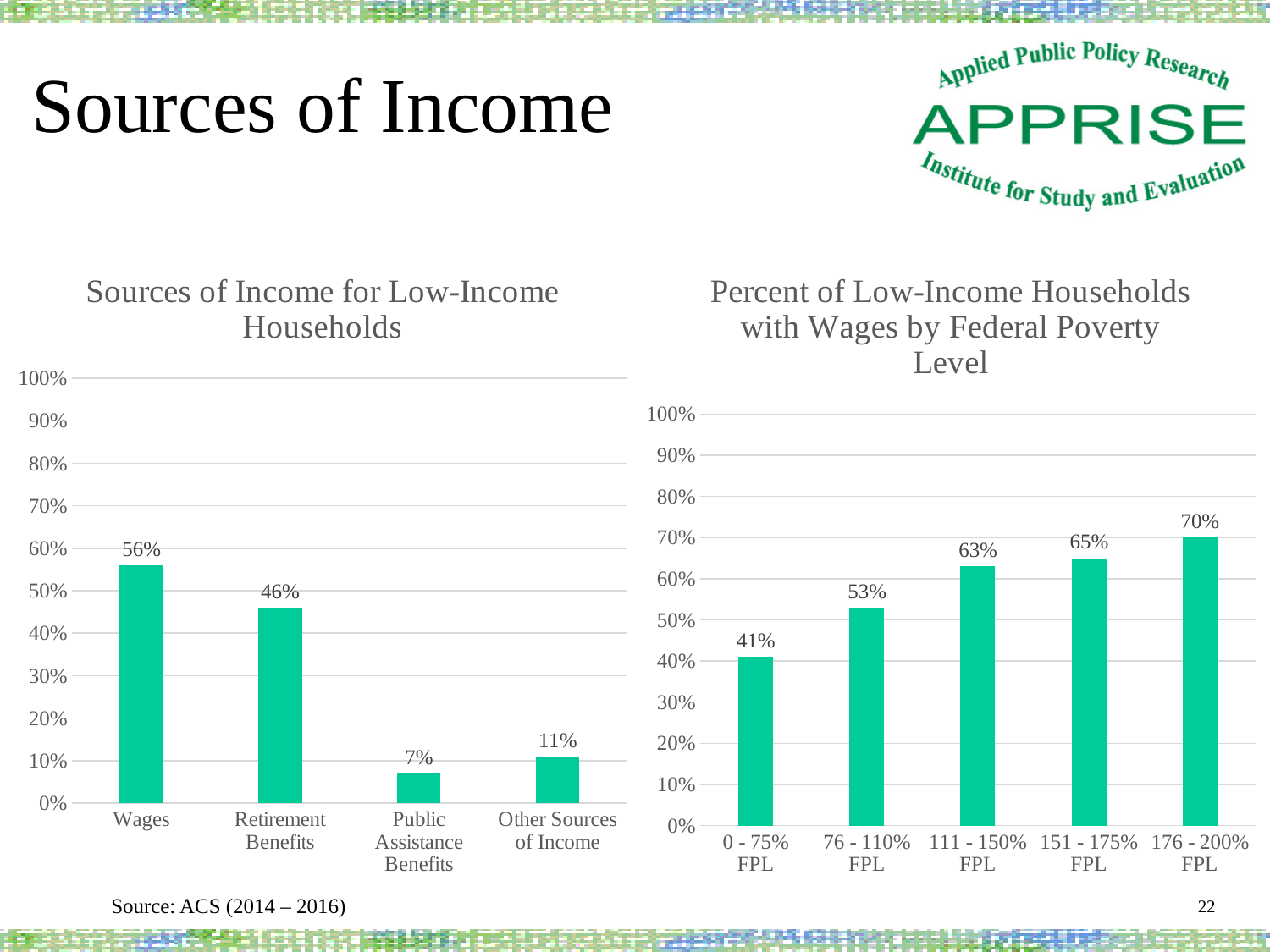
In the 'Sources of Income for Low-Income Households' chart, what is the difference between Wages and Retirement Benefits? 10% In the 'Sources of Income for Low-Income Households' chart, what is the value for Public Assistance Benefits? 7% In the 'Percent of Low-Income Households with Wages by Federal Poverty Level' chart, what is the difference between 176 - 200% FPL and 0 - 75% FPL? 29% In the 'Sources of Income for Low-Income Households' chart, which category has the lowest value? Public Assistance Benefits In the 'Percent of Low-Income Households with Wages by Federal Poverty Level' chart, what is the value for 176 - 200% FPL? 70% What kind of chart is the 'Percent of Low-Income Households with Wages by Federal Poverty Level' chart? bar chart In the 'Sources of Income for Low-Income Households' chart, what is the value for Wages? 56% In the 'Percent of Low-Income Households with Wages by Federal Poverty Level' chart, do the values rise or fall as the federal poverty level increases along the x axis? rise In the 'Percent of Low-Income Households with Wages by Federal Poverty Level' chart, what is the value for 76 - 110% FPL? 53% In the 'Sources of Income for Low-Income Households' chart, which category has the highest value? Wages In the 'Percent of Low-Income Households with Wages by Federal Poverty Level' chart, which category has the lowest value? 0 - 75% FPL In the 'Sources of Income for Low-Income Households' chart, how many categories are shown? 4